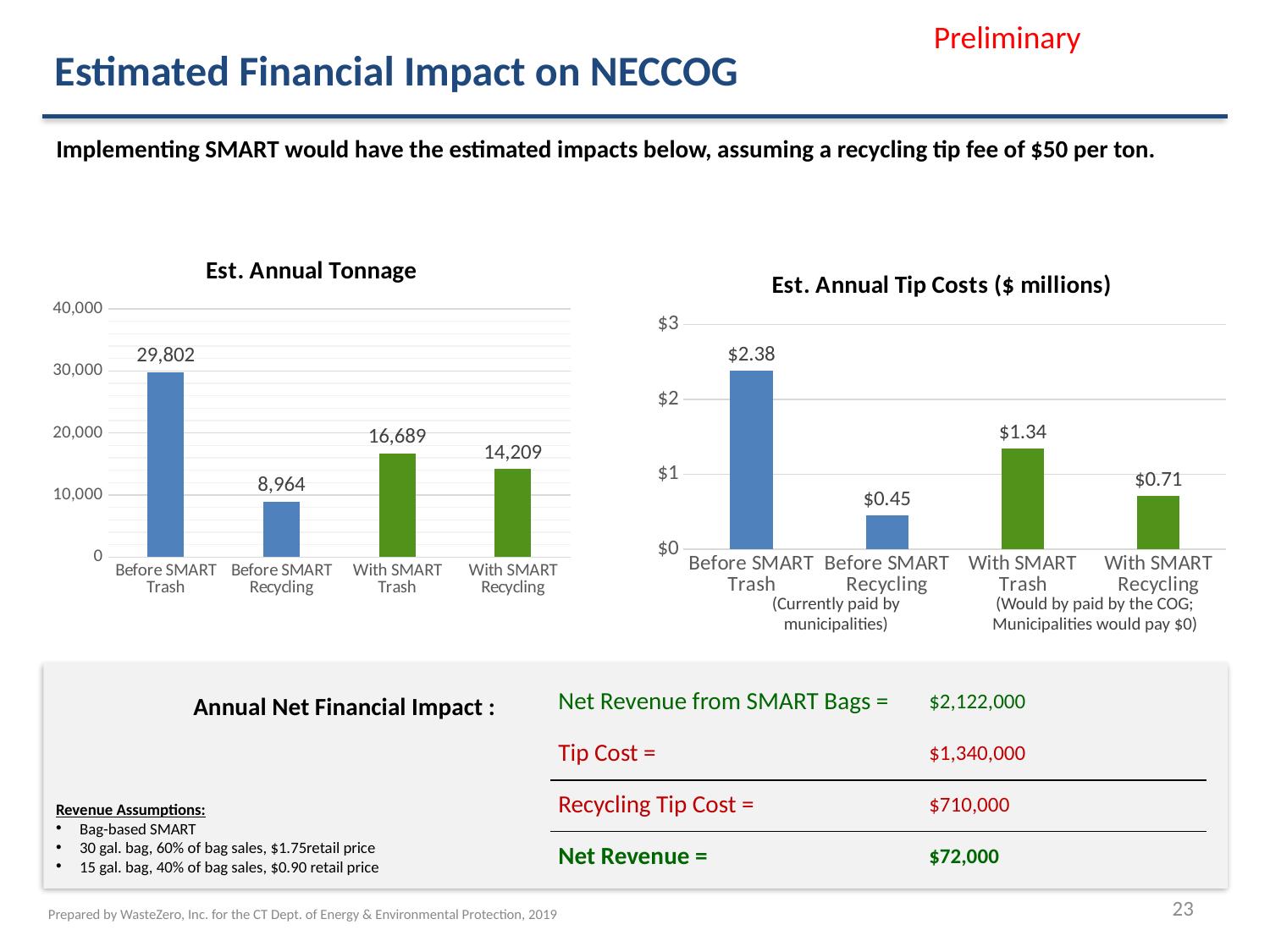
In the Est. Annual Tip Costs ($ millions) chart, which category has the highest value? Before SMART Trash In the Est. Annual Tonnage chart, what is the value for With SMART Recycling? 14,209 In the Est. Annual Tip Costs ($ millions) chart, what is the difference between Before SMART Trash and With SMART Trash? $1.04 In the Est. Annual Tonnage chart, which category has the lowest value? Before SMART Recycling What type of chart is the Est. Annual Tip Costs ($ millions) chart? bar chart In the Est. Annual Tonnage chart, what is the value for Before SMART Trash? 29,802 In the Est. Annual Tip Costs ($ millions) chart, which is larger: With SMART Recycling or Before SMART Recycling? With SMART Recycling In the Est. Annual Tonnage chart, is the value for With SMART Trash greater or less than 20,000? less In the Est. Annual Tonnage chart, what is the difference between Before SMART Trash and With SMART Trash? 13,113 How many categories are shown in the Est. Annual Tonnage chart? 4 In the Est. Annual Tip Costs ($ millions) chart, what is the value for With SMART Trash? $1.34 In the Est. Annual Tip Costs ($ millions) chart, what is the value for Before SMART Recycling? $0.45